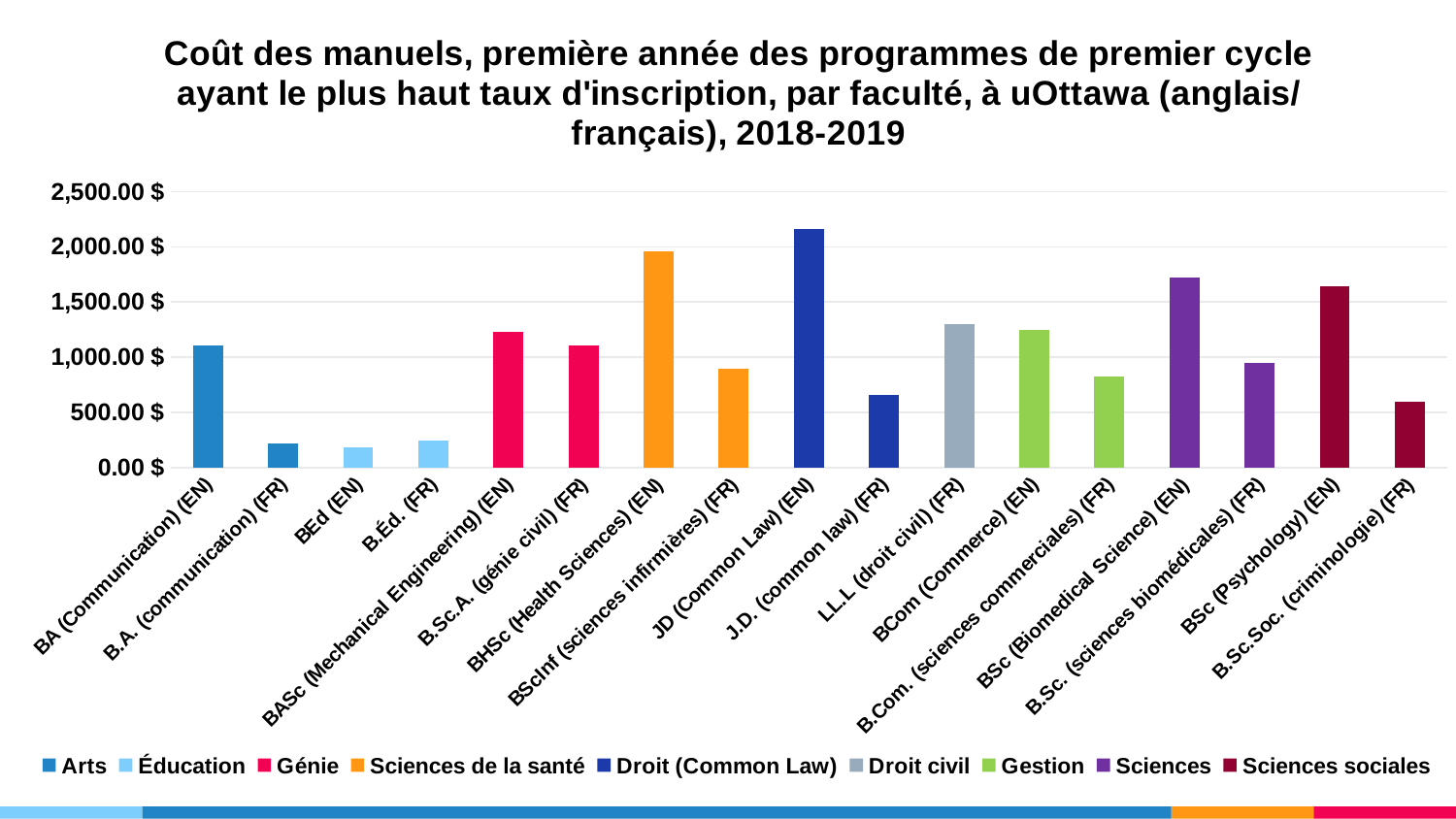
Which faculty does the legend associate with the orange bars? Sciences de la santé How many faculties does the legend list? 9 Is the value for BScInf (sciences infirmières) (FR) greater or less than 1,000.00 $? less Is the value for LL.L (droit civil) (FR) greater or less than 1,000.00 $? greater Is the value for B.A. (communication) (FR) greater or less than 500.00 $? less Which program has the highest textbook cost in the chart? JD (Common Law) (EN) What kind of chart is shown on the slide? bar chart How many programs (bars) are plotted in the chart? 17 Which is larger, the value for JD (Common Law) (EN) or BHSc (Health Sciences) (EN)? JD (Common Law) (EN) Which is larger, the value for BCom (Commerce) (EN) or B.Com. (sciences commerciales) (FR)? BCom (Commerce) (EN)